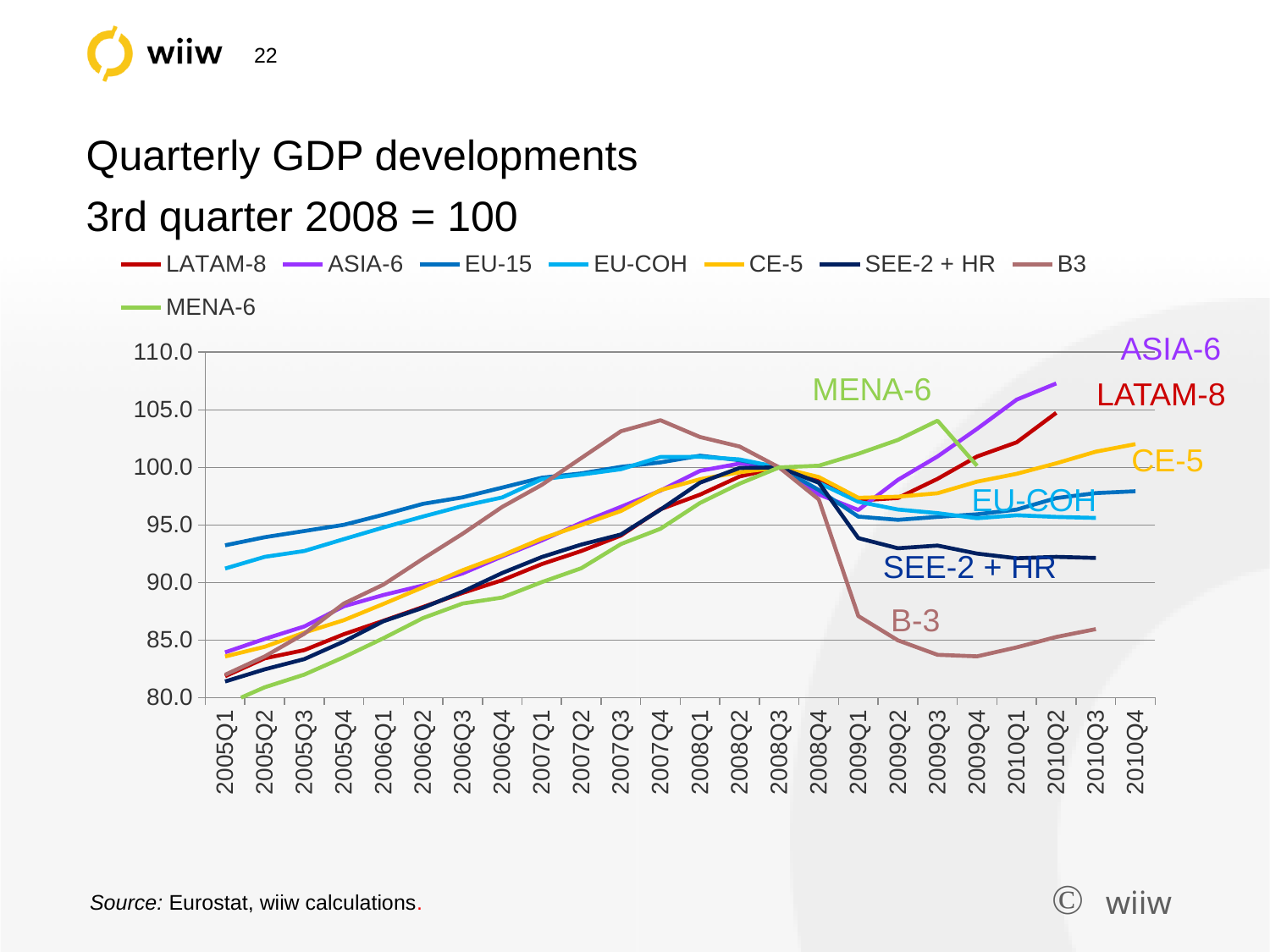
In 2010Q2, which is larger: LATAM-8 or B3? LATAM-8 Which series has the lowest value in 2010Q4? EU-15 How many series does the legend list? 8 Is the value for EU-15 in 2005Q1 greater or less than 90.0? greater What is the index value of every series in 2008Q3? 100 Is the value for ASIA-6 in 2010Q2 greater or less than 105.0? greater How many quarters are shown along the x axis? 24 Does the B3 series rise or fall between 2008Q3 and 2009Q3? fall Is the value for B3 in 2009Q4 greater or less than 85.0? less What kind of chart is shown on the slide? line chart Which series has the highest value in 2010Q2? ASIA-6